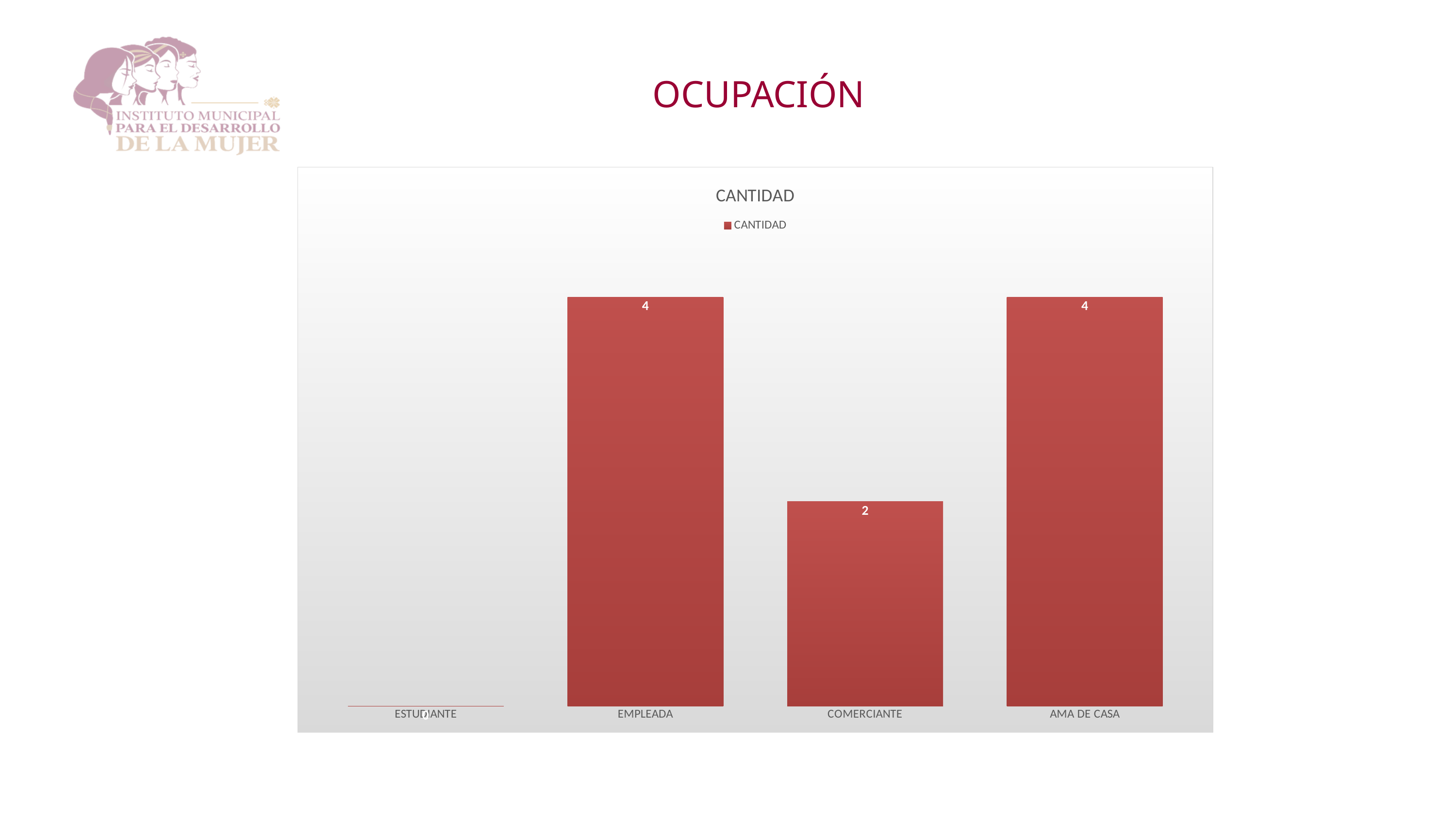
What is the name of the series in the legend? CANTIDAD How many categories are shown on the x axis? 4 What is the value for COMERCIANTE? 2 What is the title of the chart? CANTIDAD How many series does the legend list? 1 Which is larger, the value for COMERCIANTE or the value for ESTUDIANTE? COMERCIANTE What is the value for EMPLEADA? 4 What is the value for AMA DE CASA? 4 What is the difference between the values for EMPLEADA and COMERCIANTE? 2 Which is larger, the value for AMA DE CASA or the value for COMERCIANTE? AMA DE CASA What kind of chart is shown? bar chart Which category has the lowest value? ESTUDIANTE